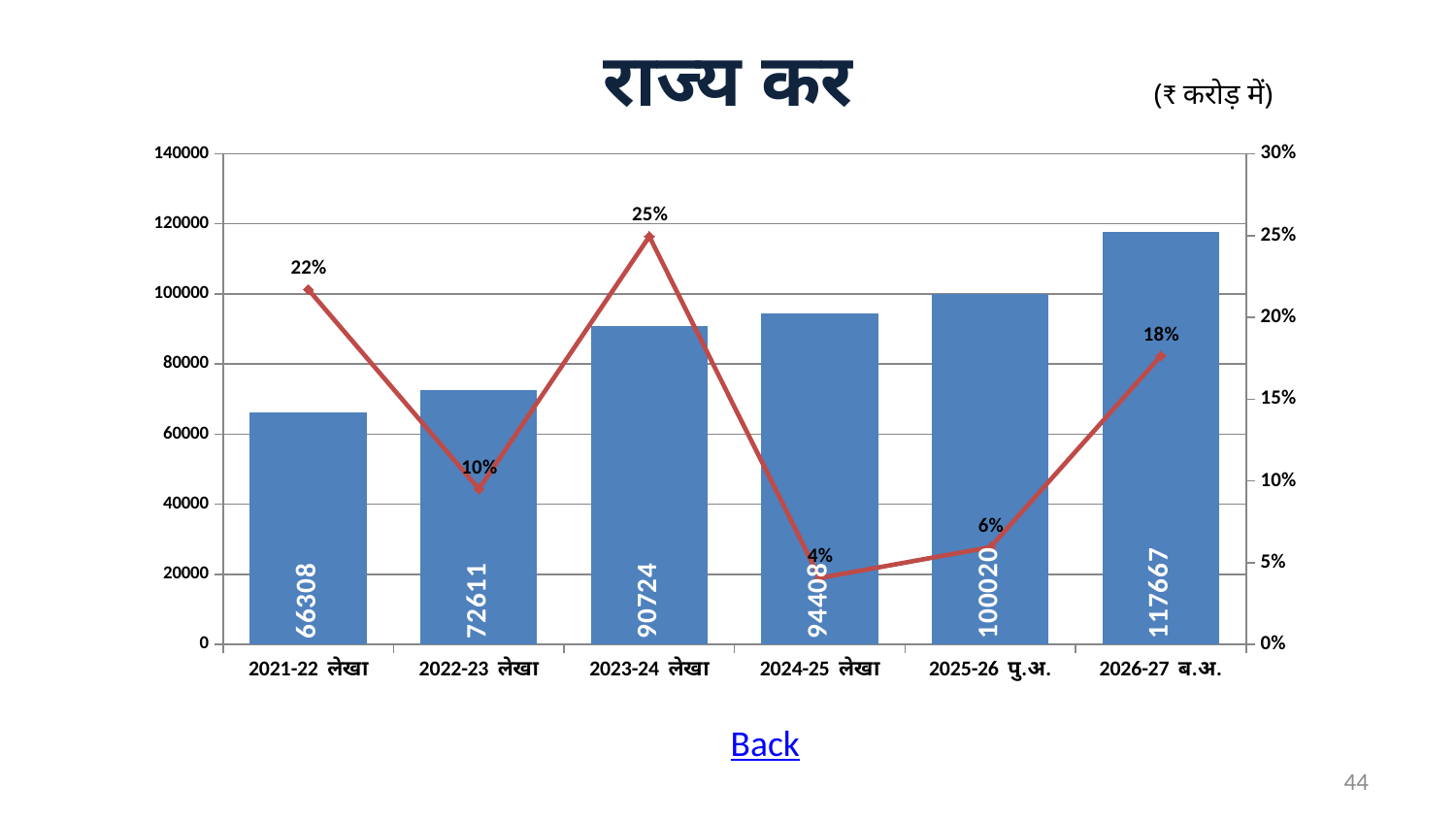
What is the title of the chart? राज्य कर Which category has the lowest growth percentage on the line? 2024-25 लेखा What is the value of the bar for 2026-27 ब.अ.? 117667 What growth percentage is shown on the line for 2021-22 लेखा? 22% Which is larger, the bar value for 2022-23 लेखा or for 2021-22 लेखा? 2022-23 लेखा What is the value of the bar for 2023-24 लेखा? 90724 Do the bar values rise or fall from 2021-22 लेखा to 2026-27 ब.अ.? rise Which category has the highest growth percentage on the line? 2023-24 लेखा What is the difference between the bar values for 2025-26 पु.अ. and 2024-25 लेखा? 5612 How many categories are shown on the x axis? 6 Which category has the highest bar value? 2026-27 ब.अ. What growth percentage is shown on the line for 2024-25 लेखा? 4%